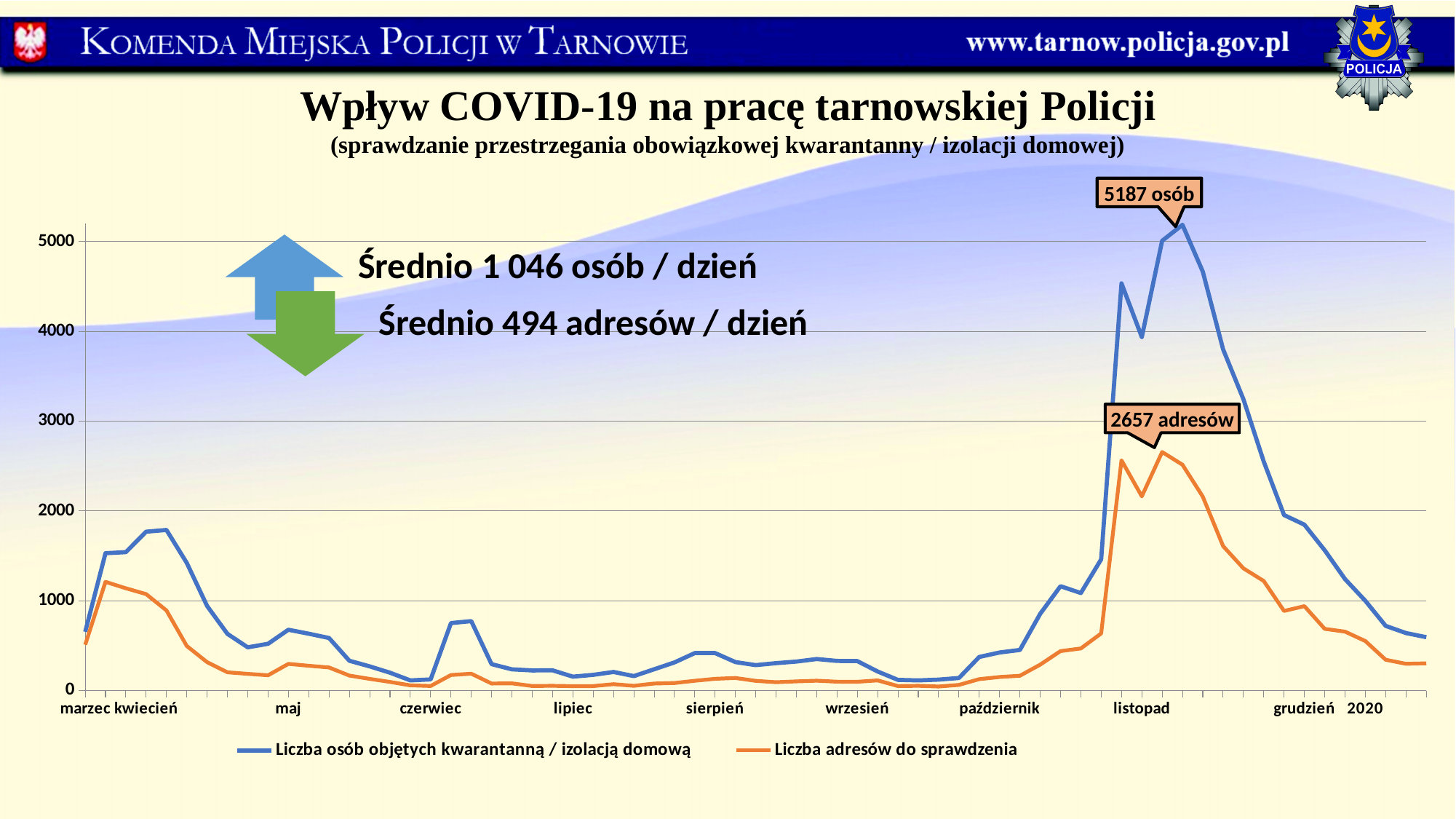
Do the values of both series rise or fall from the listopad peak towards grudzień? fall Is the value of 'Liczba adresów do sprawdzenia' at the kwiecień label greater or less than 2000? less Is the value of 'Liczba osób objętych kwarantanną / izolacją domową' in lipiec greater or less than 1000? less What is the peak value labelled for the series 'Liczba adresów do sprawdzenia'? 2657 adresów What is the peak value labelled for the series 'Liczba osób objętych kwarantanną / izolacją domową'? 5187 osób What kind of chart is shown on the slide? line chart What is the difference between the labelled peak of 5187 osób and the labelled peak of 2657 adresów? 2530 In which month do both series reach their highest values? listopad How many series does the legend list? 2 Is the value of 'Liczba osób objętych kwarantanną / izolacją domową' at the kwiecień label greater or less than 1000? greater According to the text on the slide, what is the average number of persons per day (Średnio ... osób / dzień)? 1 046 osób / dzień Which series reaches the higher peak, 'Liczba osób objętych kwarantanną / izolacją domową' or 'Liczba adresów do sprawdzenia'? Liczba osób objętych kwarantanną / izolacją domową